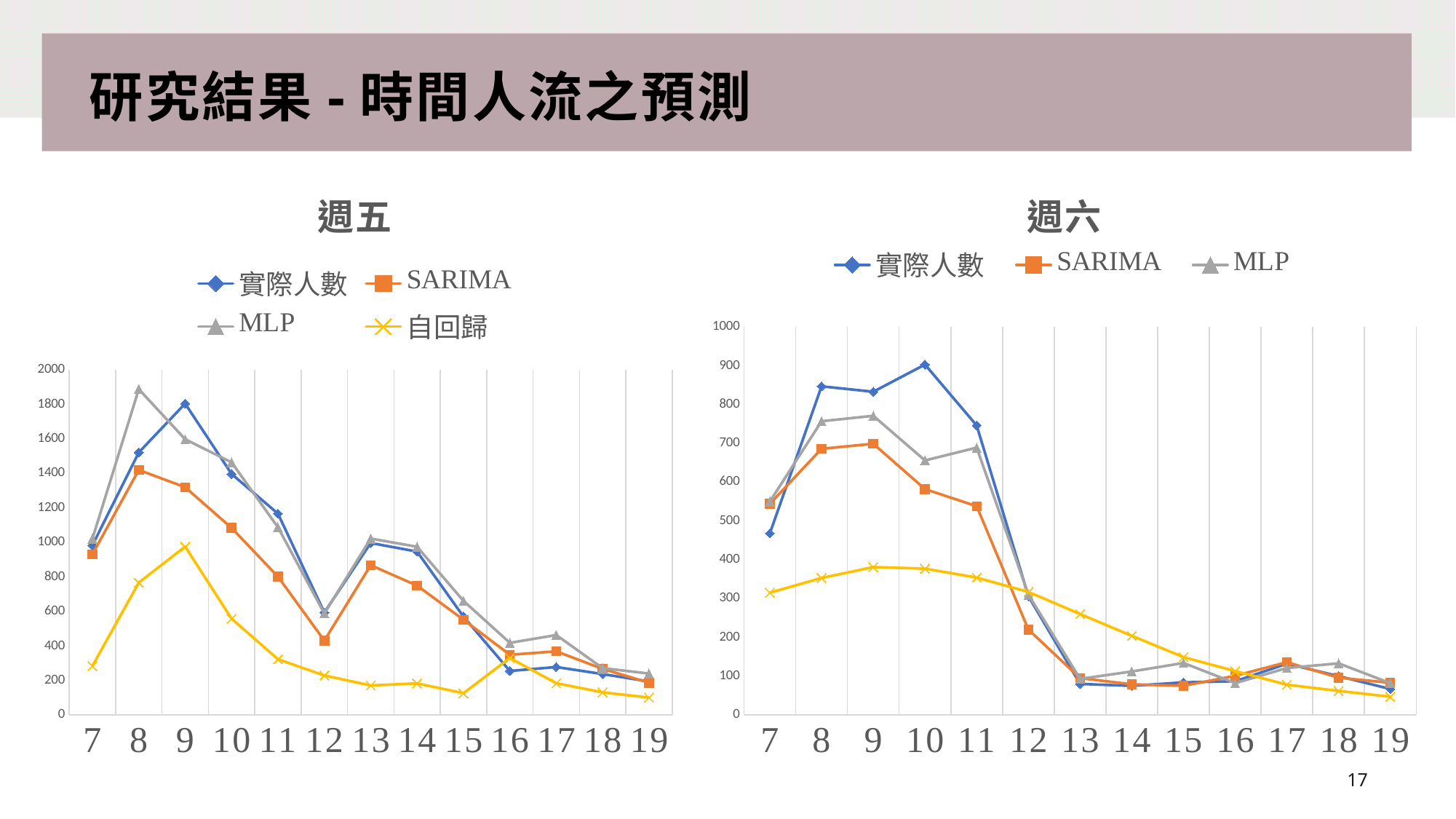
In the 週六 chart, is the 實際人數 value at hour 10 greater or less than 800? greater In the 週五 chart, at which hour is 實際人數 highest? 9 In the 週六 chart, is the SARIMA value at hour 12 greater or less than 300? less How many hours are shown on the x axis of the 週六 chart? 13 In the 週五 chart, at hour 8, which is larger, MLP or 實際人數? MLP How many series does the legend of the 週六 chart list? 3 In the 週六 chart, at which hour is 實際人數 highest? 10 How many series does the legend of the 週五 chart list? 4 In the 週六 chart, at hour 9, which is larger, 實際人數 or SARIMA? 實際人數 In the 週五 chart, is the 自回歸 value at hour 9 greater or less than 800? greater What kind of chart is the 週五 chart? line chart